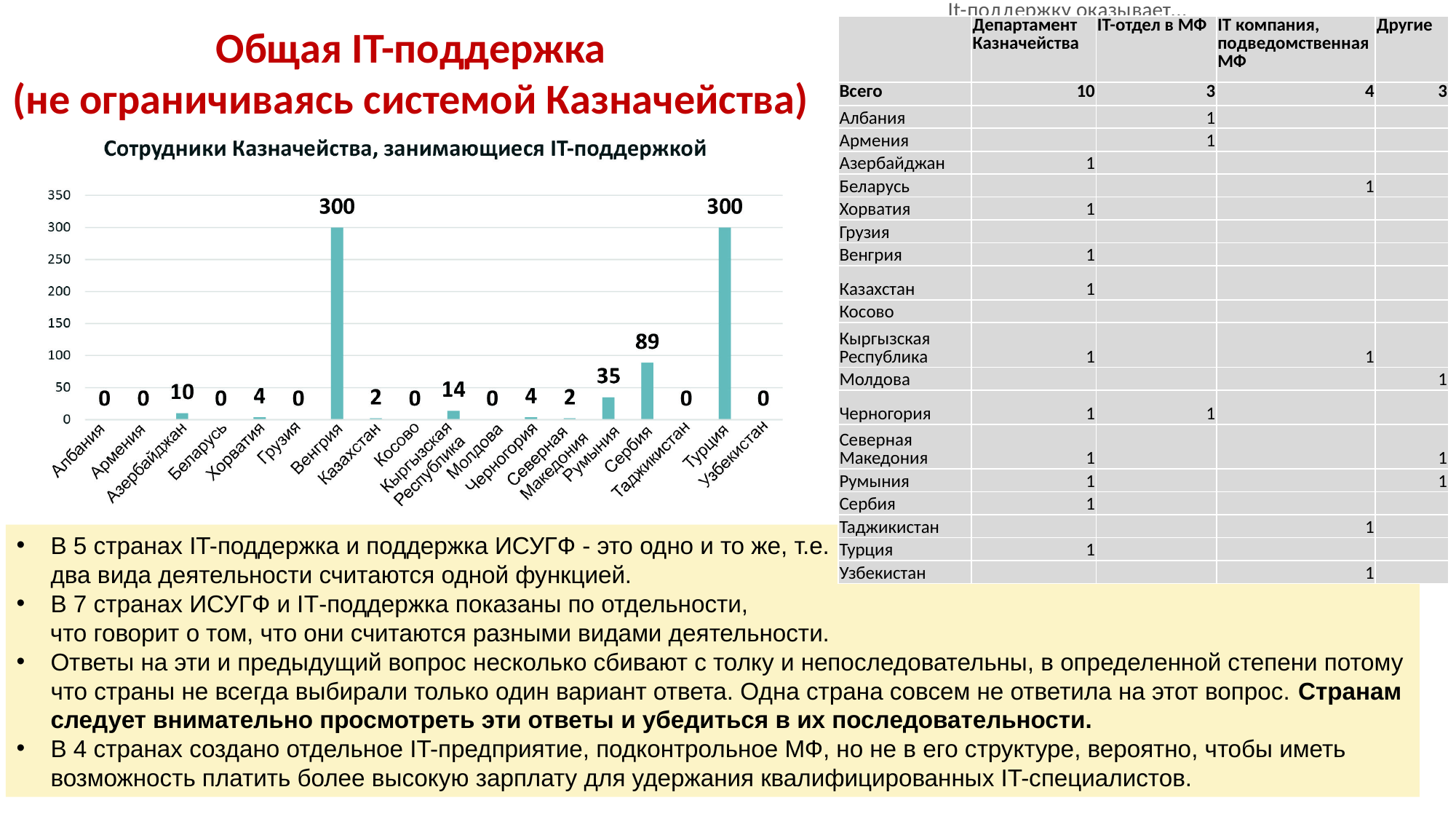
What is the value for Румыния in the chart? 35 Which has a larger value, Сербия or Румыния? Сербия Which countries share the highest value in the chart? Венгрия and Турция What is the value for Сербия in the chart? 89 Is the value for Сербия greater or less than 100? less What is the difference between the values for Сербия and Румыния? 54 What is the title of the chart on the slide? Сотрудники Казначейства, занимающиеся IT-поддержкой What is the value for Азербайджан in the chart? 10 What is the value for Венгрия in the chart? 300 How many countries are shown on the x axis of the chart? 18 What is the value for Кыргызская Республика in the chart? 14 What type of chart is shown on the slide? bar chart